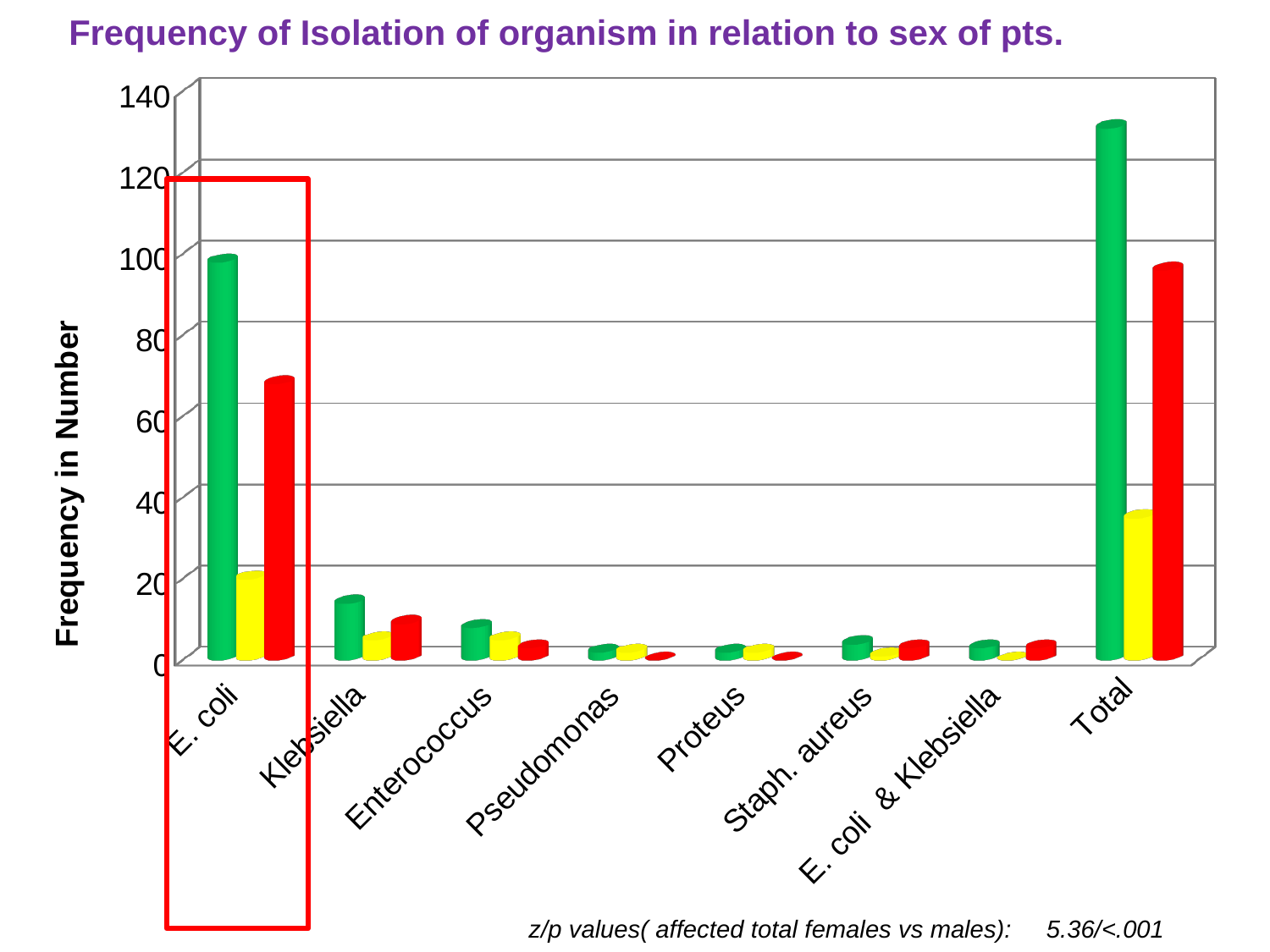
What kind of chart is shown on the slide? bar chart Is the value of the red bar for E. coli greater or less than 60? greater Is the value of the red bar for Total greater or less than 100? less How many categories are shown along the x axis of the chart? 8 What is the title of the chart? Frequency of Isolation of organism in relation to sex of pts. Is the value of the green bar for E. coli greater or less than 80? greater Which category has the tallest green bar? Total Among the individual organisms (excluding Total), which category has the tallest green bar? E. coli What is the label on the vertical axis of the chart? Frequency in Number For E. coli, which bar is taller, the green bar or the red bar? green